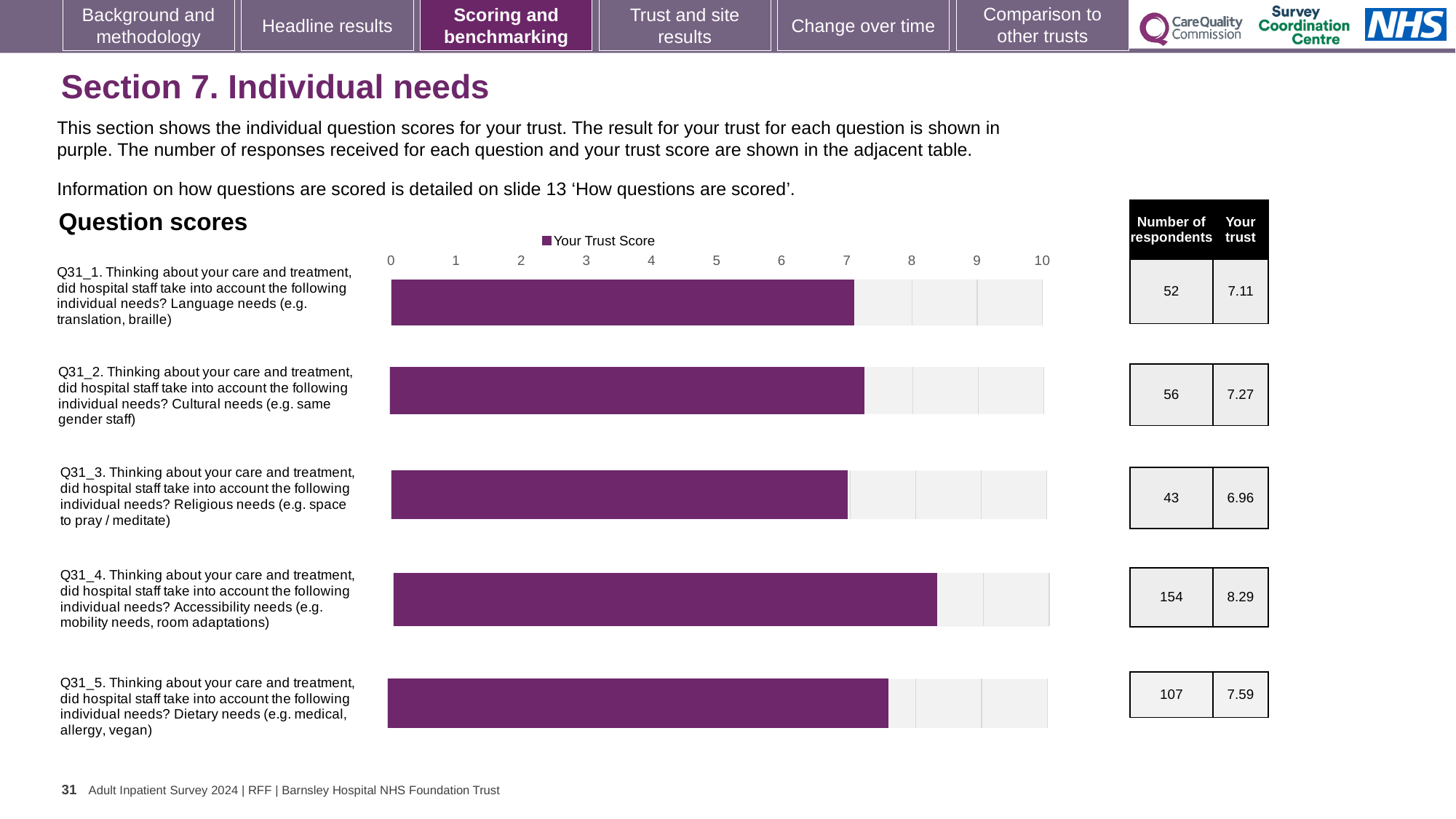
What is the trust score for Q31_4 (Accessibility needs)? 8.29 Is the value for Q31_4 (Accessibility needs) greater or less than 8? greater How many respondents answered Q31_5 (Dietary needs)? 107 What is the difference between the trust scores for Q31_4 (Accessibility needs) and Q31_3 (Religious needs)? 1.33 Which has the larger trust score, Q31_2 (Cultural needs) or Q31_5 (Dietary needs)? Q31_5 (Dietary needs) What is the trust score for Q31_1 (Language needs)? 7.11 Which question has the lowest trust score? Q31_3 (Religious needs) What type of chart is used to show the question scores? Bar chart Which question has the highest trust score? Q31_4 (Accessibility needs) How many questions are plotted in the Question scores chart? 5 What is the trust score for Q31_3 (Religious needs)? 6.96 What series name is shown in the chart legend? Your Trust Score